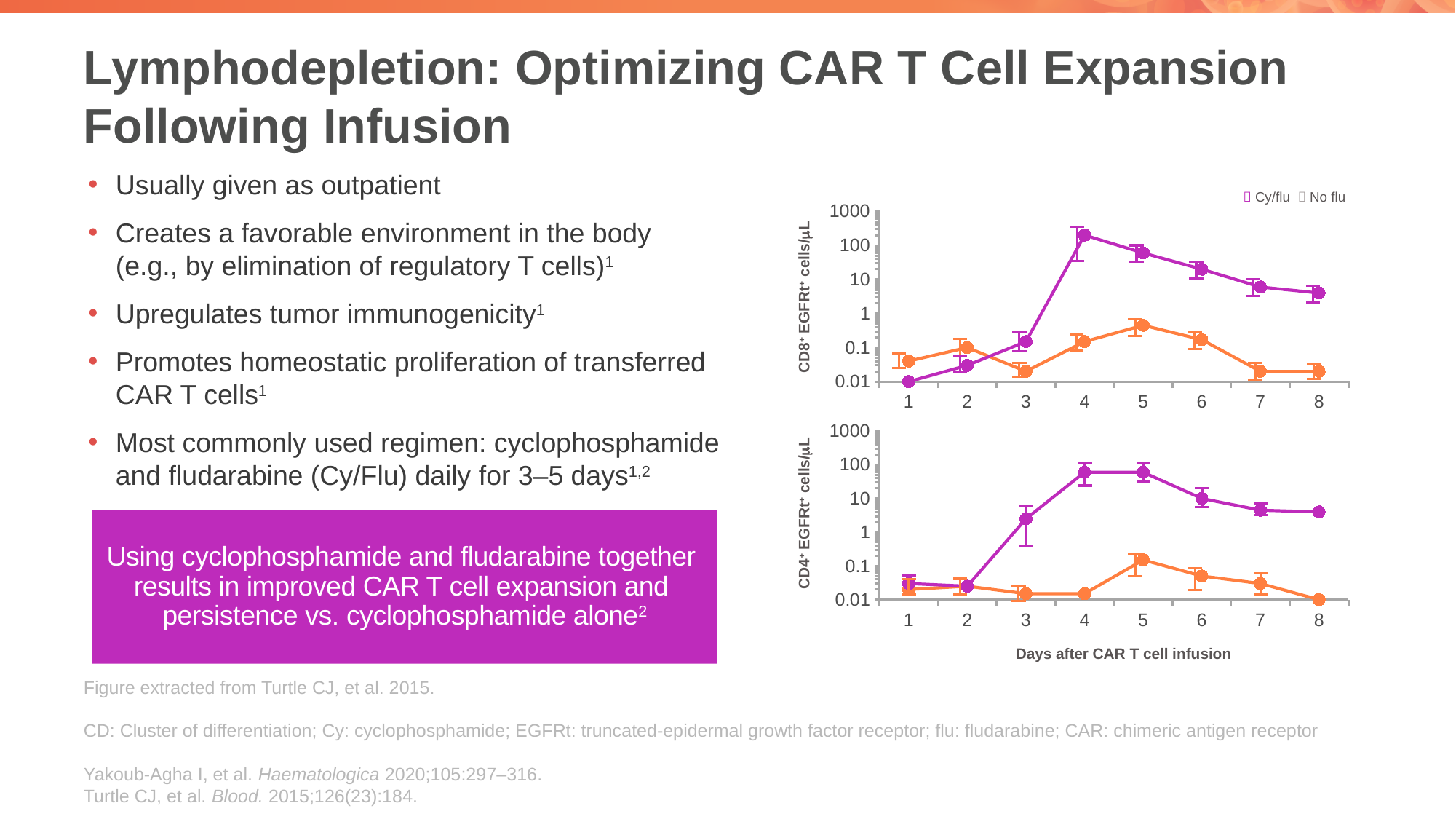
In the top chart (CD8+ EGFRt+ cells/µL), on which day does the No flu series reach its highest value? Day 5 In the top chart (CD8+ EGFRt+ cells/µL), does the Cy/flu series rise or fall from day 4 to day 8? Fall In the top chart (CD8+ EGFRt+ cells/µL), which series has the larger value at day 1, Cy/flu or No flu? No flu In the top chart (CD8+ EGFRt+ cells/µL), is the Cy/flu value at day 4 greater or less than 100? greater In the top chart (CD8+ EGFRt+ cells/µL), is the No flu value at day 8 greater or less than 0.1? less How many series does the legend list for the charts? 2 What is the x-axis title shown below the bottom chart? Days after CAR T cell infusion What type of chart is the top chart (CD8+ EGFRt+ cells/µL)? Line chart In the bottom chart (CD4+ EGFRt+ cells/µL), is the Cy/flu value at day 4 greater or less than 10? greater In the bottom chart (CD4+ EGFRt+ cells/µL), which series has the larger value at day 6, Cy/flu or No flu? Cy/flu In the top chart (CD8+ EGFRt+ cells/µL), on which day does the Cy/flu series reach its highest value? Day 4 In the top chart (CD8+ EGFRt+ cells/µL), how many days are plotted along the x axis? 8